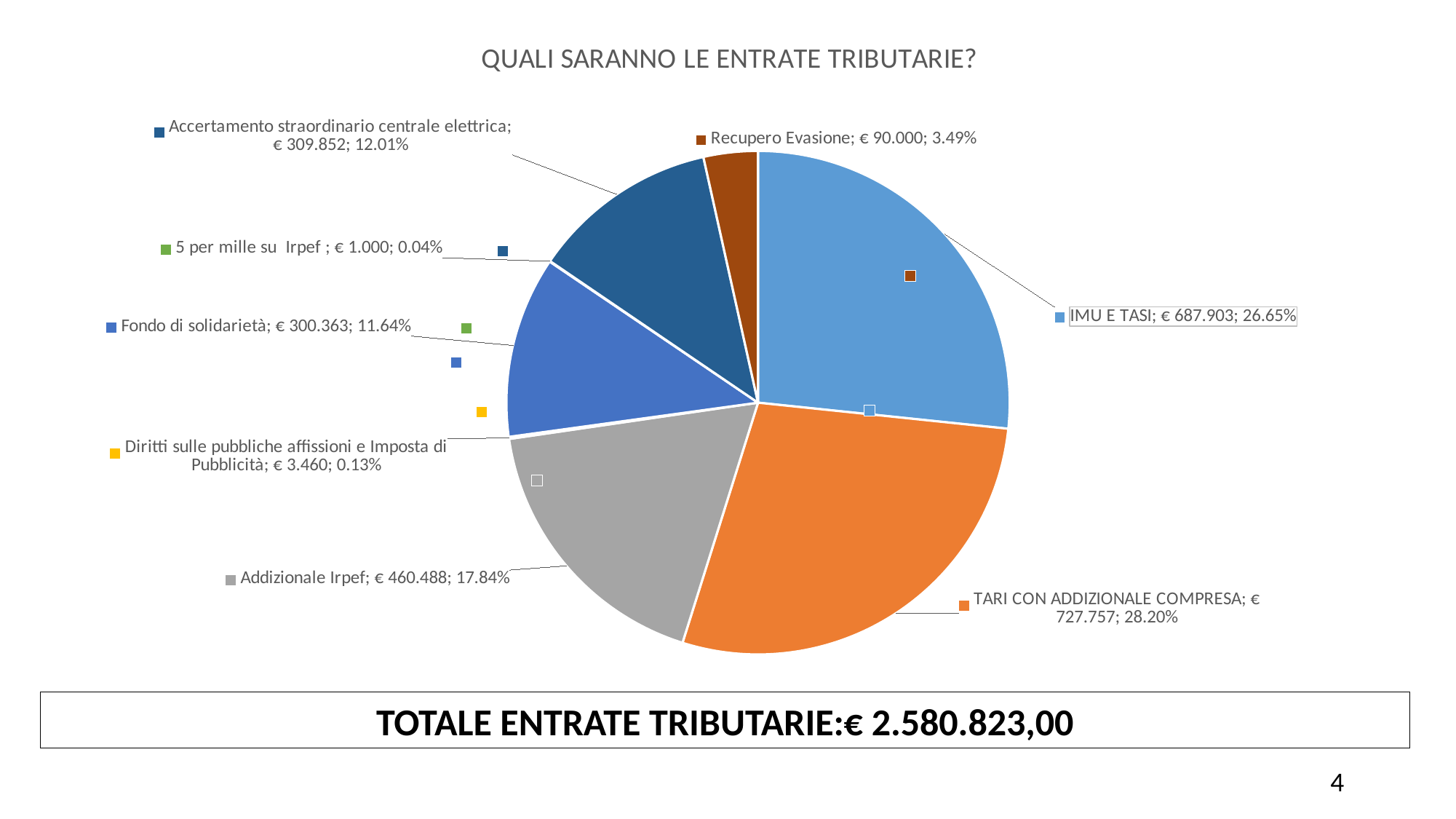
What is the value for IMU E TASI? € 687.903 What is the title of the chart? QUALI SARANNO LE ENTRATE TRIBUTARIE? What is the difference in value between TARI CON ADDIZIONALE COMPRESA and IMU E TASI? € 39.854 What share of the pie does Recupero Evasione represent? 3.49% What kind of chart is shown on the slide? Pie chart How many slices does the pie chart have? 8 Which category has the largest slice of the pie? TARI CON ADDIZIONALE COMPRESA Which is larger, Fondo di solidarietà or Accertamento straordinario centrale elettrica? Accertamento straordinario centrale elettrica What share of the pie does TARI CON ADDIZIONALE COMPRESA represent? 28.20% What is the value for Addizionale Irpef? € 460.488 Which category has the smallest slice of the pie? 5 per mille su Irpef What total is stated in the box below the chart? € 2.580.823,00